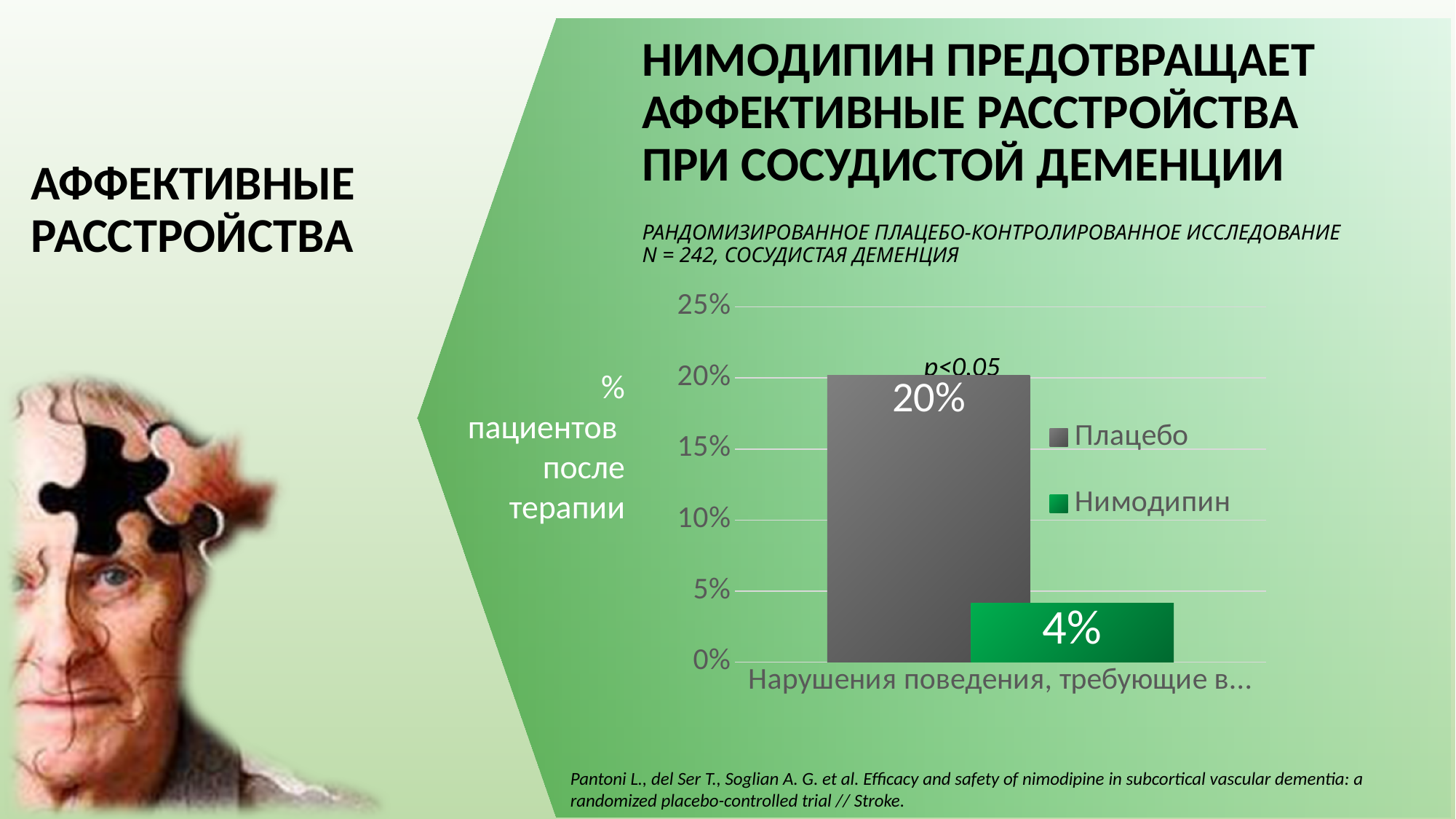
Which series has the higher value, Плацебо or Нимодипин? Плацебо Is the value for Плацебо greater or less than 15%? greater What p-value is printed above the bars? p<0,05 Which series has the lowest value? Нимодипин What is the difference between the Плацебо and Нимодипин values? 16% What colour is the Нимодипин bar? green How many series does the legend list? 2 What is the value for Плацебо? 20% What is the highest value shown on the y axis? 25% Is the value for Нимодипин greater or less than 5%? less What is the value for Нимодипин? 4% What kind of chart is shown on the slide? bar chart